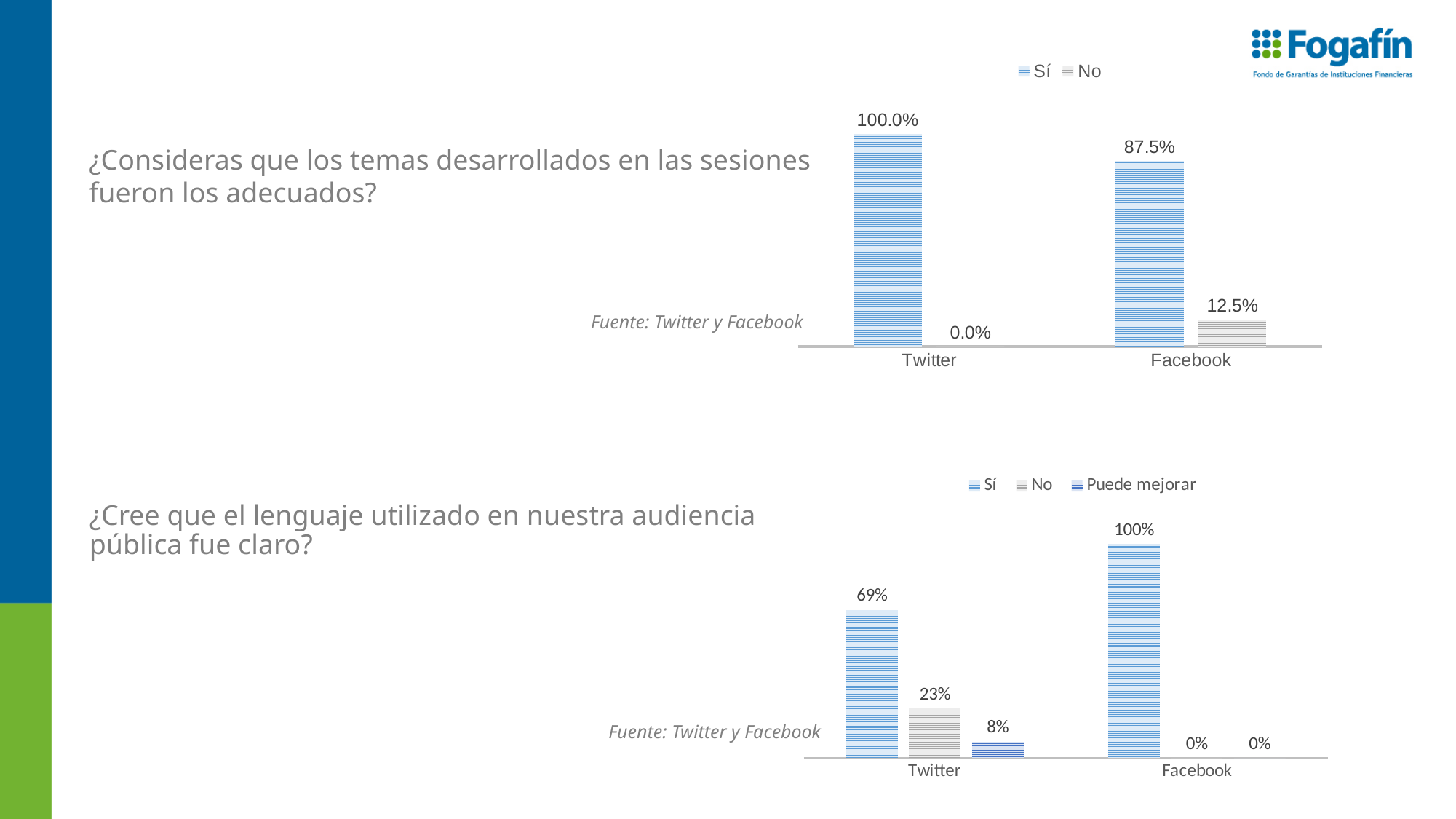
In the bottom chart, how many series does the legend list? 3 In the top chart, what is the difference between the Sí values for Twitter and Facebook? 12.5% In the top chart, which platform has the higher Sí value, Twitter or Facebook? Twitter In the top chart, how many series does the legend list? 2 In the bottom chart (¿Cree que el lenguaje utilizado en nuestra audiencia pública fue claro?), what is the value for Sí for Twitter? 69% In the bottom chart, what is the difference between the No and Puede mejorar values for Twitter? 15% In the top chart, what is the value for Sí for Facebook? 87.5% In the top chart, what is the value for No for Facebook? 12.5% In the bottom chart, what is the value for No for Twitter? 23% In the top chart (¿Consideras que los temas desarrollados en las sesiones fueron los adecuados?), what is the value for Sí for Twitter? 100.0% What kind of chart is the bottom chart? Bar chart In the bottom chart, what is the value for Puede mejorar for Twitter? 8%